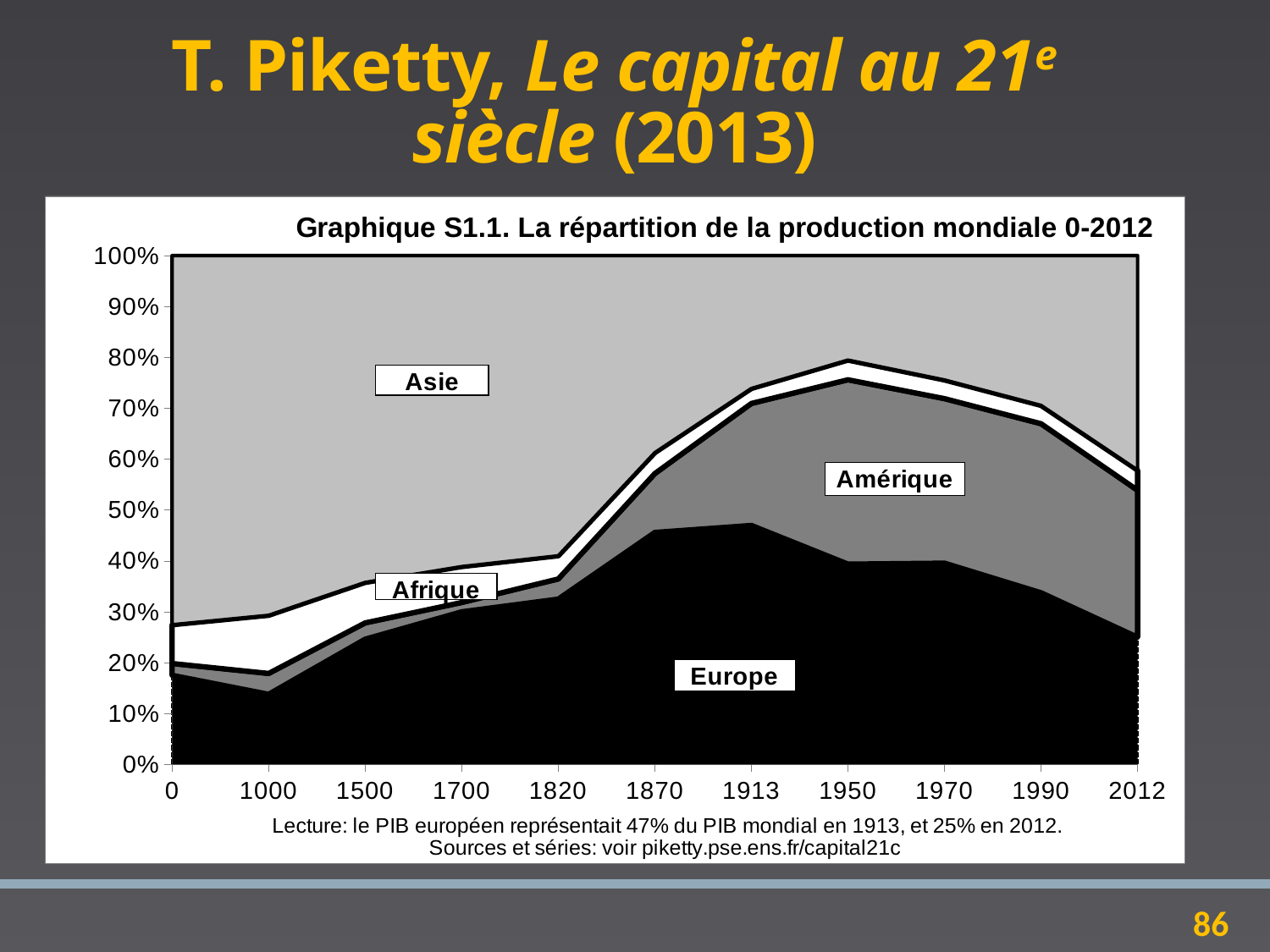
What is the title of the chart? Graphique S1.1. La répartition de la production mondiale 0-2012 How many regions are labelled in the chart? 4 What kind of chart is shown on the slide? Stacked area chart According to the note under the chart, what share of world GDP did Europe represent in 2012? 25% Does Europe's share of world production rise or fall between 1913 and 2012? fall How many years are marked on the x axis of the chart? 11 Was Europe's share of world GDP larger in 1913 or in 2012? 1913 By how many percentage points did Europe's share of world GDP fall between 1913 and 2012? 22 percentage points In which year shown does Europe's share of world production reach its highest point? 1913 Is Europe's share of world production in 1950 greater or less than 50%? less Is Europe's share of world production in the year 1000 greater or less than 20%? less According to the note under the chart, what share of world GDP did Europe represent in 1913? 47%